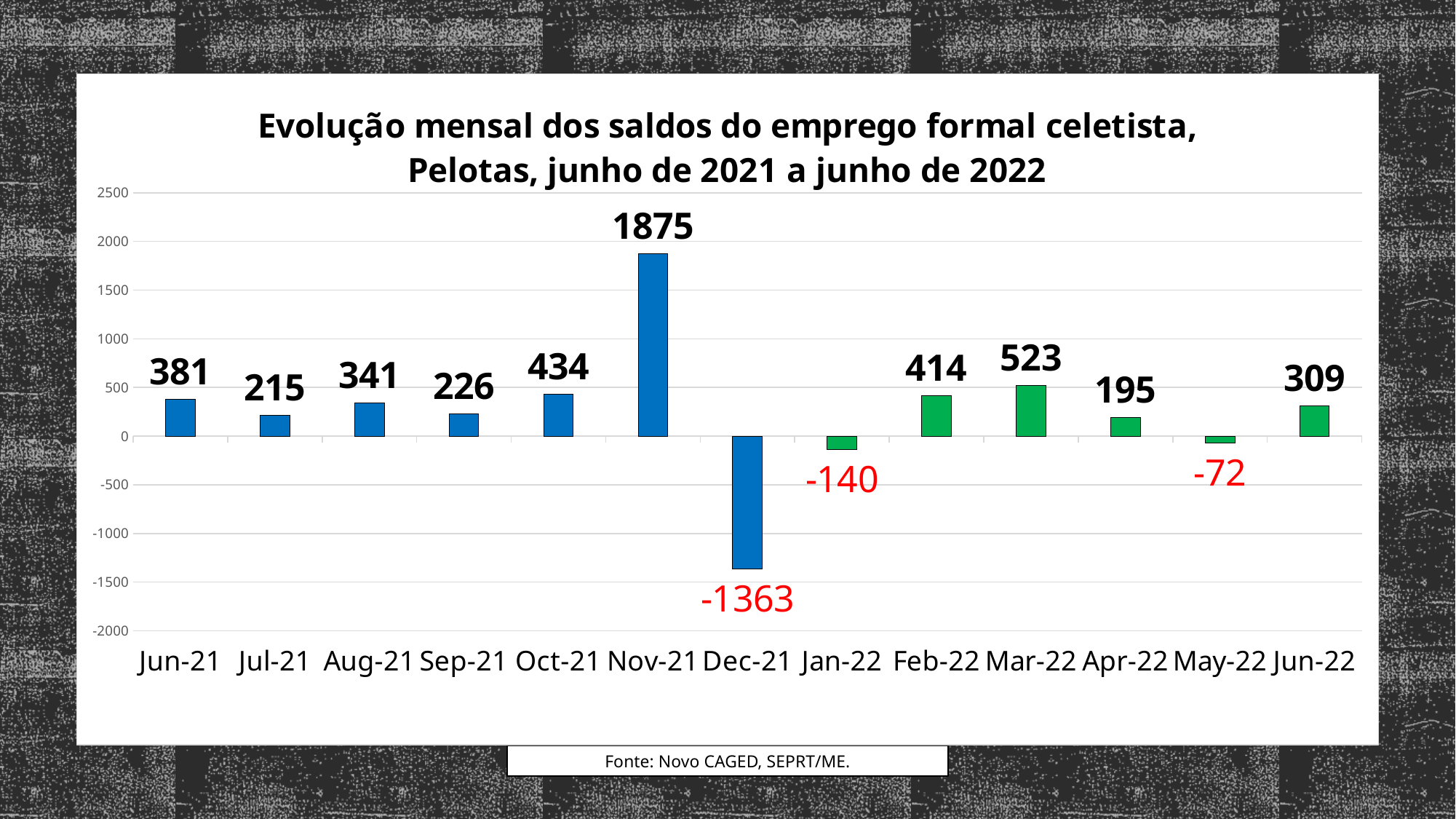
What is the value for Nov-21? 1875 How many months have a negative value? 3 What is the difference between the values for Jun-21 and Jun-22? 72 What colour are the bars for the 2022 months? Green Which is larger, the value for Oct-21 or the value for Feb-22? Oct-21 What is the value for May-22? -72 What is the value for Dec-21? -1363 How many months are shown on the x axis? 13 Which month has the lowest value? Dec-21 Which month has the highest value? Nov-21 What is the value for Mar-22? 523 What kind of chart is this? Bar chart